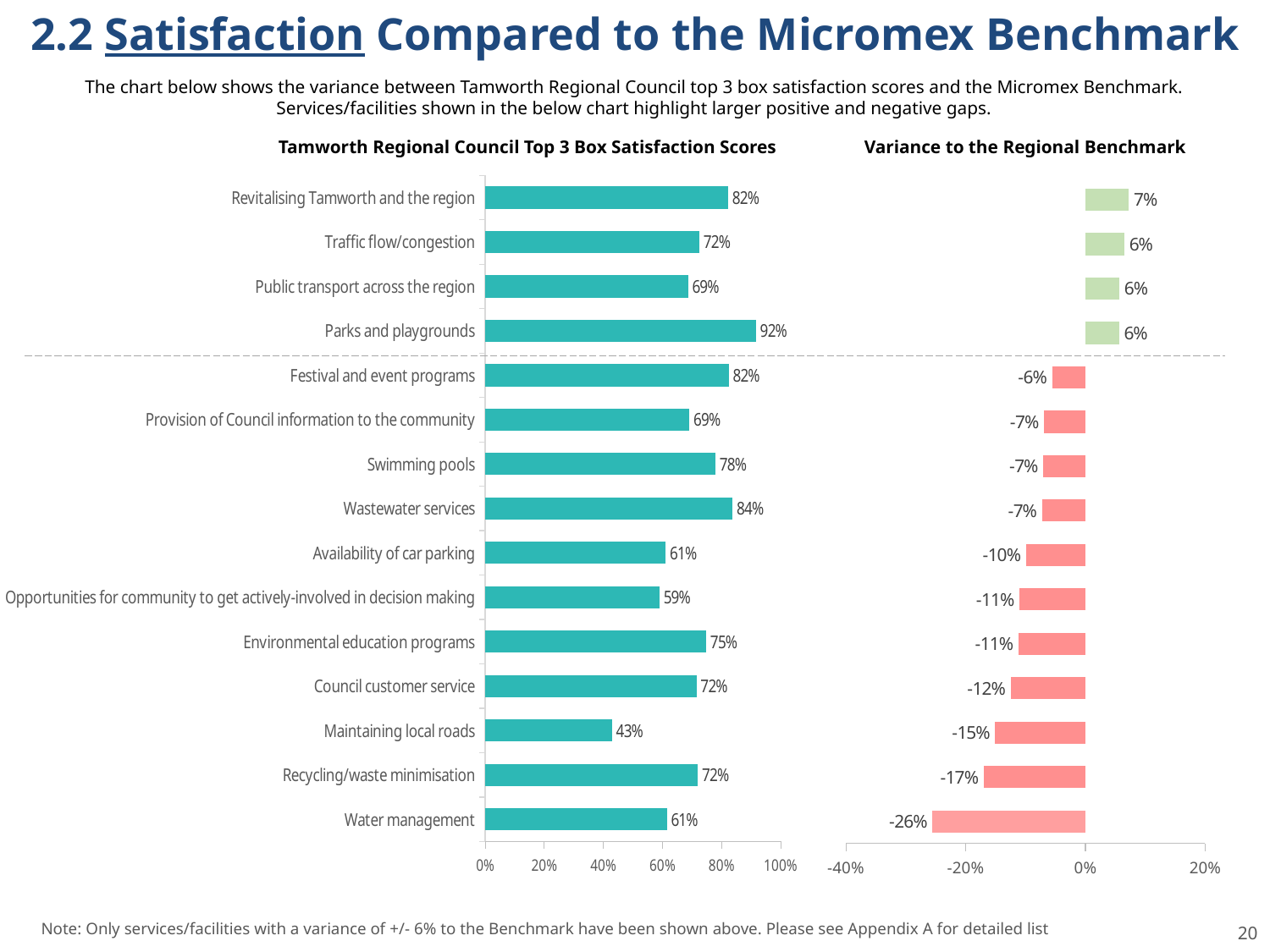
In the Variance to the Regional Benchmark chart, which service has the largest negative variance? Water management In the Variance to the Regional Benchmark chart, what is the variance for Water management? -26% In the Tamworth Regional Council Top 3 Box Satisfaction Scores chart, which service has the lowest satisfaction score? Maintaining local roads In the Tamworth Regional Council Top 3 Box Satisfaction Scores chart, what is the satisfaction score for Maintaining local roads? 43% What type of chart is the Tamworth Regional Council Top 3 Box Satisfaction Scores chart? Bar chart In the Variance to the Regional Benchmark chart, what is the variance for Recycling/waste minimisation? -17% In the Variance to the Regional Benchmark chart, what is the variance for Revitalising Tamworth and the region? 7% In the Tamworth Regional Council Top 3 Box Satisfaction Scores chart, what is the difference between the scores for Wastewater services and Availability of car parking? 23% In the Tamworth Regional Council Top 3 Box Satisfaction Scores chart, which service has the highest satisfaction score? Parks and playgrounds In the Tamworth Regional Council Top 3 Box Satisfaction Scores chart, which has a higher score: Swimming pools or Environmental education programs? Swimming pools How many services/facilities are shown in the Tamworth Regional Council Top 3 Box Satisfaction Scores chart? 15 In the Tamworth Regional Council Top 3 Box Satisfaction Scores chart, what is the satisfaction score for Parks and playgrounds? 92%